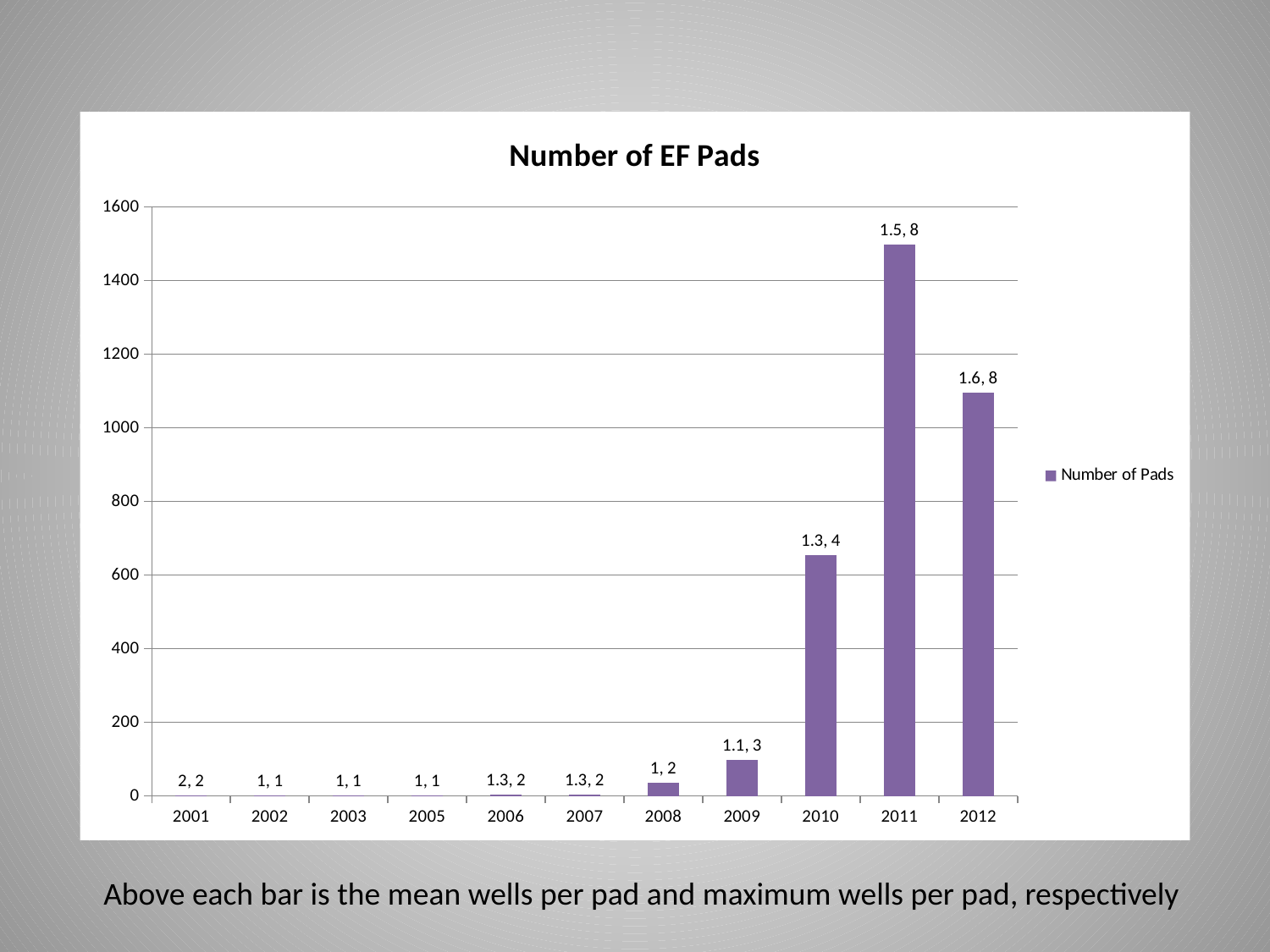
What is the title of the chart? Number of EF Pads Is the value for 2010 greater or less than 800? less How many series does the legend list? 1 How many years are shown on the x axis of the chart? 11 What label is printed above the bar for 2011? 1.5, 8 What kind of chart is shown on the slide? bar chart Is the value for 2011 greater or less than 1400? greater Which year has the larger number of pads, 2009 or 2010? 2010 Which year has the highest number of EF pads? 2011 Is the value for 2009 greater or less than 200? less Which year has the larger number of pads, 2011 or 2012? 2011